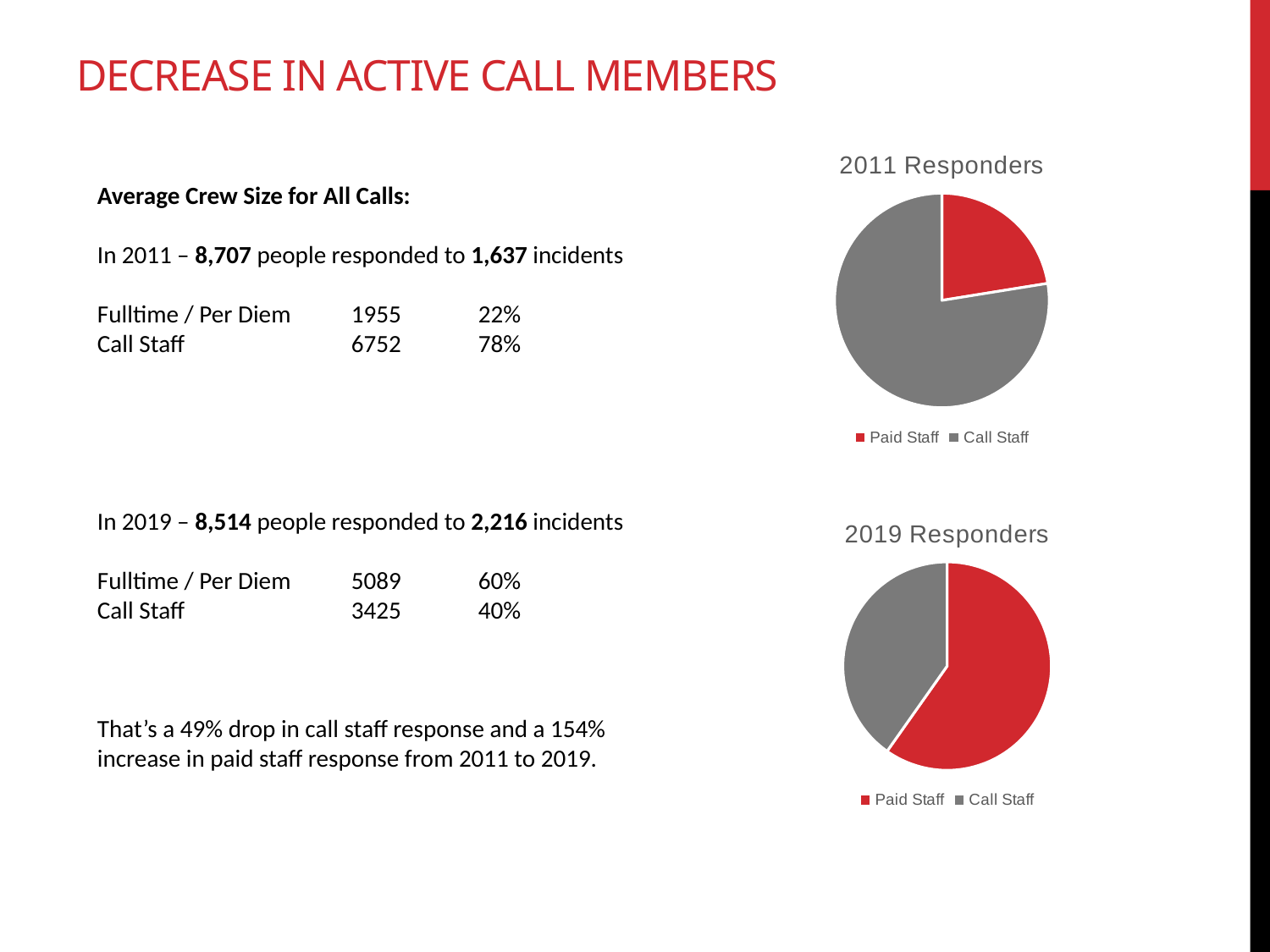
In the "2011 Responders" chart, which category has the smallest slice? Paid Staff Is the Paid Staff slice larger in the "2011 Responders" chart or the "2019 Responders" chart? 2019 Responders In the "2019 Responders" chart, what colour represents Call Staff? Grey How many entries does the legend of the "2011 Responders" chart list? 2 What kind of chart is the "2019 Responders" chart? Pie chart How many slices does the "2019 Responders" pie chart have? 2 In the "2011 Responders" chart, which category has the largest slice? Call Staff In the "2019 Responders" chart, which category has the smallest slice? Call Staff In the "2019 Responders" chart, what share of the pie is Paid Staff? 60% In the "2019 Responders" chart, which category has the largest slice? Paid Staff In the "2011 Responders" chart, what share of the pie is Call Staff? 78% What kind of chart is the "2011 Responders" chart? Pie chart